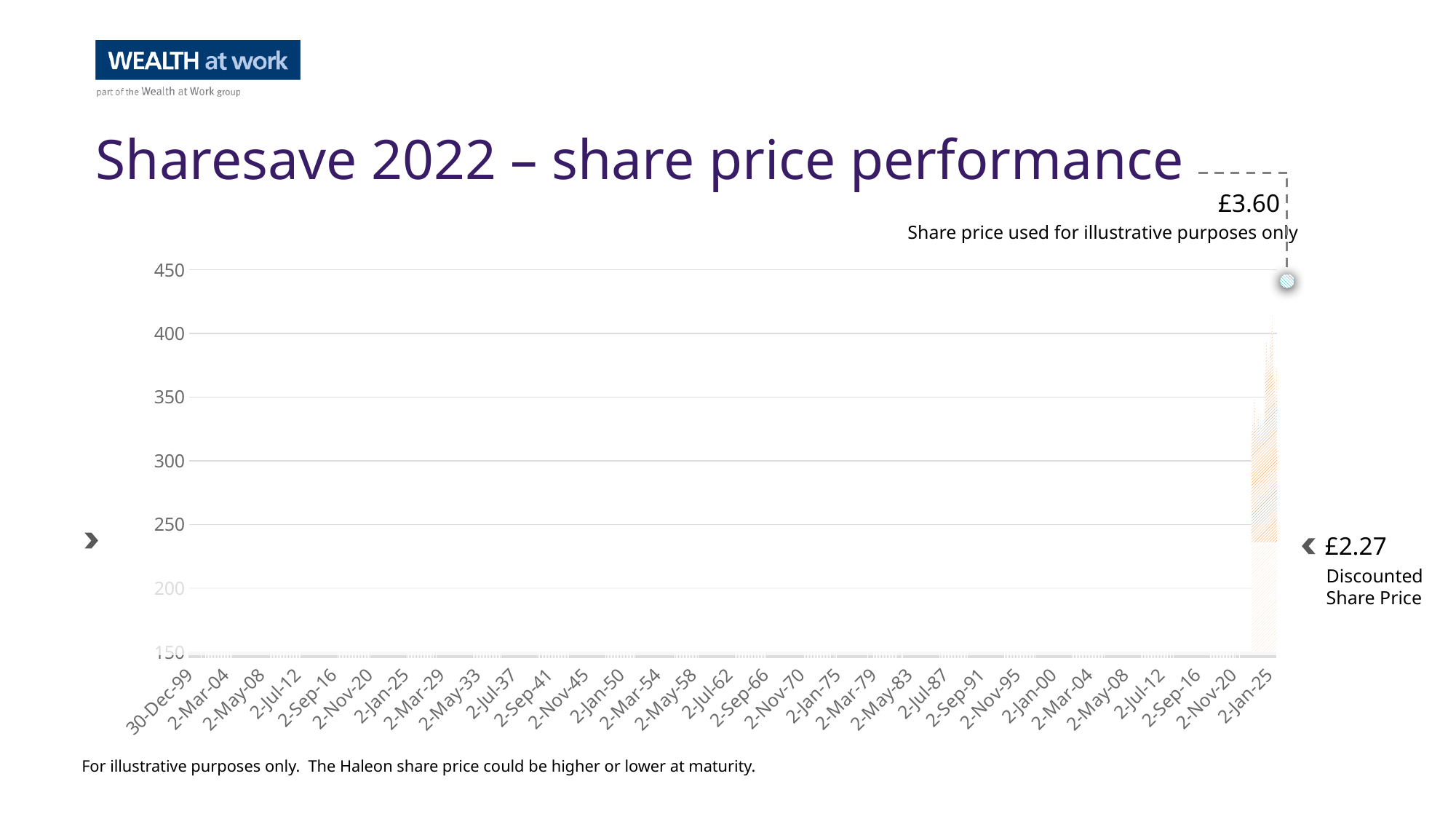
What is the title of the chart on the slide? Sharesave 2022 – share price performance What is the Discounted Share Price annotated on the right of the chart? £2.27 What is the difference between the illustrative share price (£3.60) and the Discounted Share Price (£2.27)? £1.33 Which is larger, the illustrative share price or the Discounted Share Price? The illustrative share price (£3.60) What share price is annotated at the top right of the chart as used for illustrative purposes only? £3.60 What is the first date label on the chart's horizontal axis? 30-Dec-99 What is the last date label on the chart's horizontal axis? 2-Jan-25 What is the highest value shown on the chart's vertical axis? 450